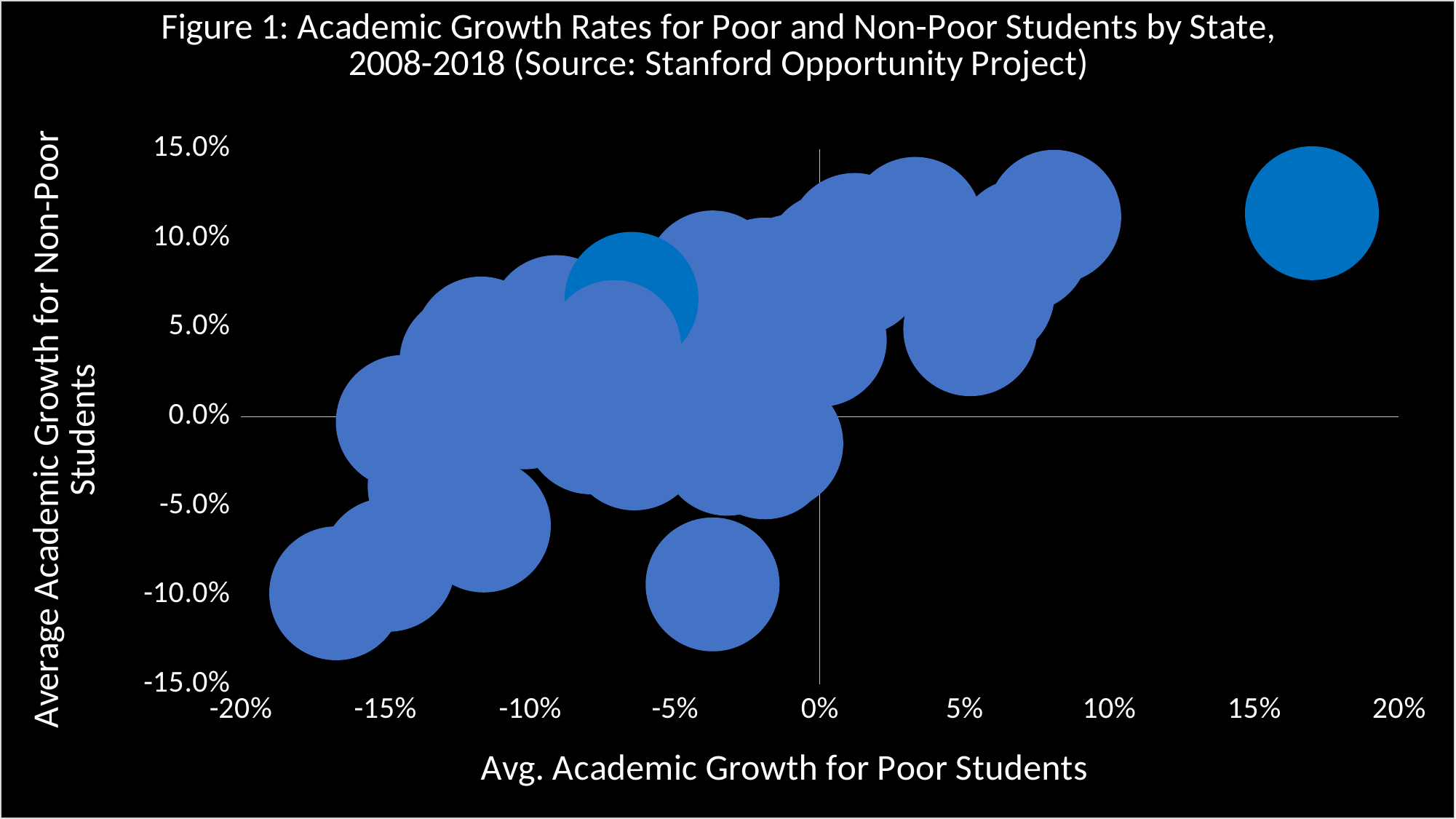
What is the label of the horizontal axis? Avg. Academic Growth for Poor Students Which of the two bubbles has the larger y-axis value: the bottom-left bubble or the rightmost bubble? the rightmost bubble What kind of chart is shown on the slide? bubble chart What is the title of the chart? Figure 1: Academic Growth Rates for Poor and Non-Poor Students by State, 2008-2018 (Source: Stanford Opportunity Project) Is the x-axis value of the rightmost bubble greater or less than 15%? greater Is the y-axis value of the rightmost bubble greater or less than 5.0%? greater As the average academic growth for poor students increases along the x axis, do the values for non-poor students generally rise or fall? rise Is the y-axis value of the isolated bubble near the bottom centre of the chart (around -5% on the x axis) greater or less than -5.0%? less Which of the two bubbles has the larger x-axis value: the rightmost bubble or the bottom-left bubble? the rightmost bubble